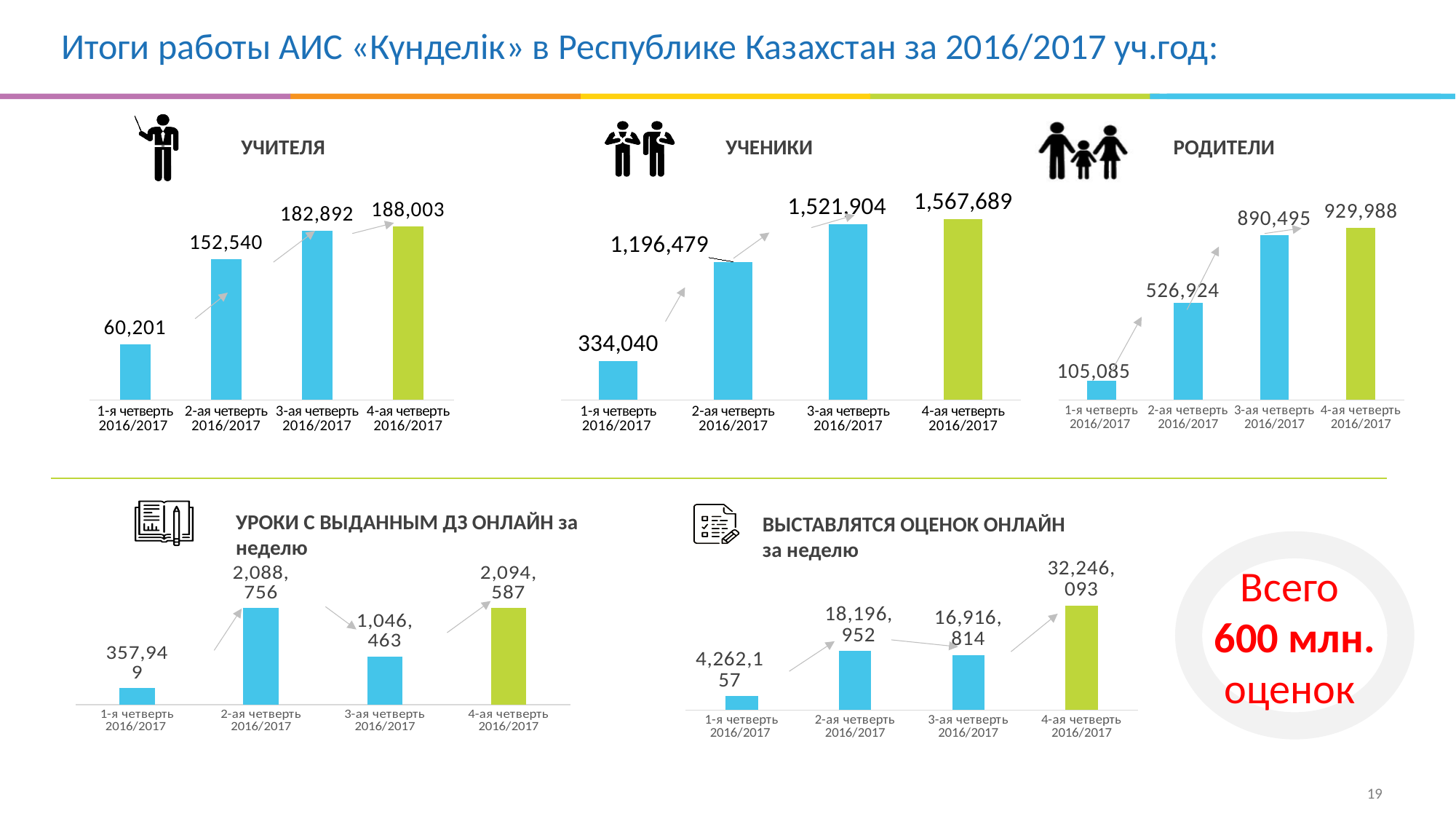
In the УРОКИ С ВЫДАННЫМ ДЗ ОНЛАЙН за неделю chart, which is larger: the value for 2-ая четверть 2016/2017 or 3-ая четверть 2016/2017? 2-ая четверть 2016/2017 In the УЧИТЕЛЯ chart, what is the difference between the values for 4-ая четверть 2016/2017 and 3-ая четверть 2016/2017? 5,111 What kind of chart is the РОДИТЕЛИ chart? Bar chart In the РОДИТЕЛИ chart, which quarter has the lowest value? 1-я четверть 2016/2017 In the УЧИТЕЛЯ chart, what is the value for 1-я четверть 2016/2017? 60,201 In the ВЫСТАВЛЯТСЯ ОЦЕНОК ОНЛАЙН за неделю chart, what is the difference between the values for 2-ая четверть 2016/2017 and 3-ая четверть 2016/2017? 1,280,138 In the УЧЕНИКИ chart, what is the value for 4-ая четверть 2016/2017? 1,567,689 In the РОДИТЕЛИ chart, what is the value for 3-ая четверть 2016/2017? 890,495 In the УРОКИ С ВЫДАННЫМ ДЗ ОНЛАЙН за неделю chart, what is the value for 3-ая четверть 2016/2017? 1,046,463 How many quarters are shown in the УЧЕНИКИ chart? 4 In the ВЫСТАВЛЯТСЯ ОЦЕНОК ОНЛАЙН за неделю chart, which quarter has the highest value? 4-ая четверть 2016/2017 In the УЧЕНИКИ chart, do the values rise or fall from 1-я четверть to 4-ая четверть 2016/2017? Rise